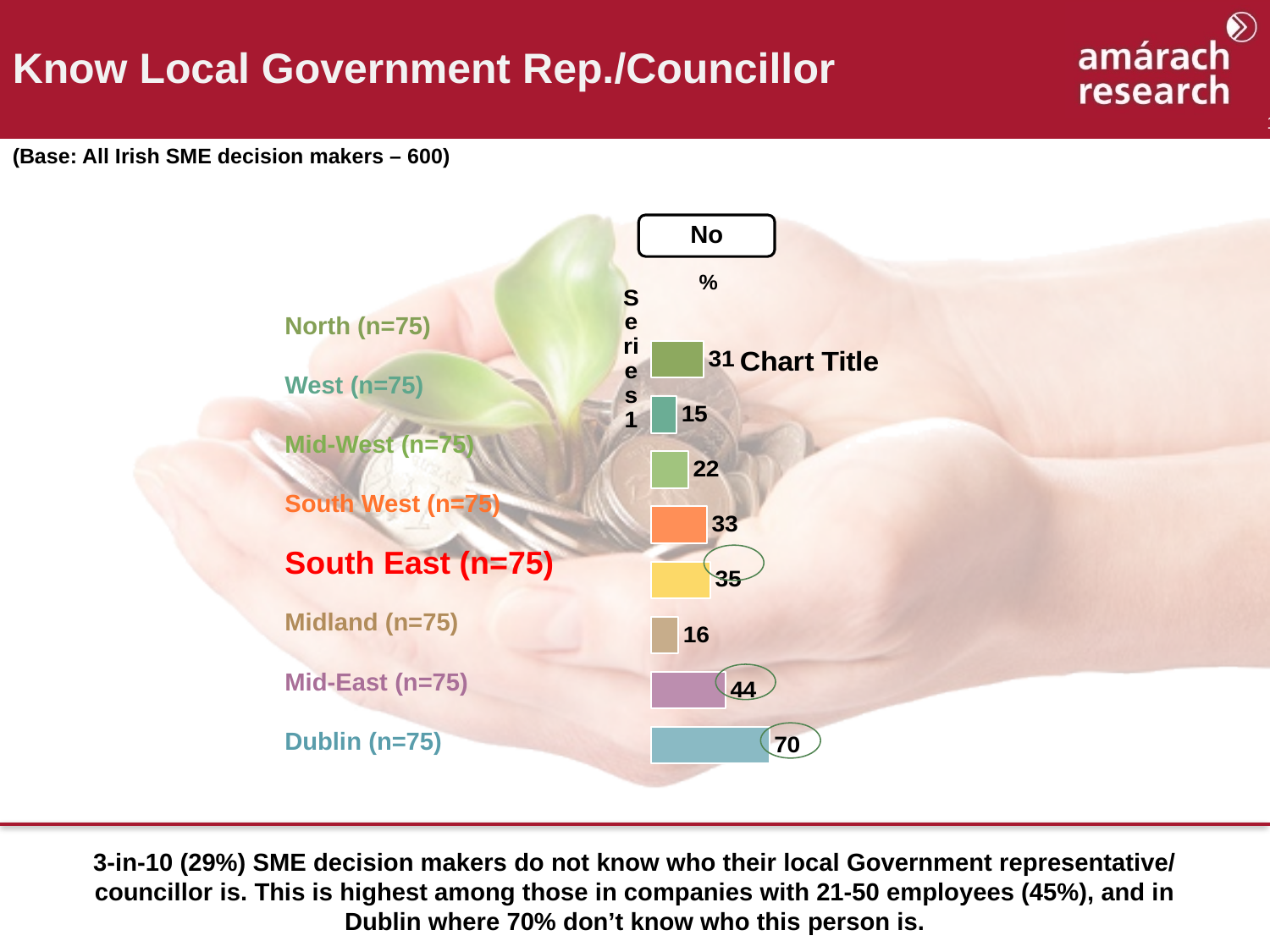
What is the value shown for Mid-East (n=75)? 44 What is the difference between the values for Dublin (n=75) and Mid-East (n=75)? 26 Which is larger, the value for South West (n=75) or the value for Mid-West (n=75)? South West (n=75) Which region has the highest value in the chart? Dublin (n=75) How many regions are plotted in the chart? 8 Which region has the lowest value in the chart? West (n=75) What is the value shown for Dublin (n=75)? 70 What is the value shown for West (n=75)? 15 What kind of chart is shown on the slide? Bar chart What is the difference between the values for North (n=75) and Midland (n=75)? 15 What is the value shown for South East (n=75)? 35 What label appears in the box above the chart? No